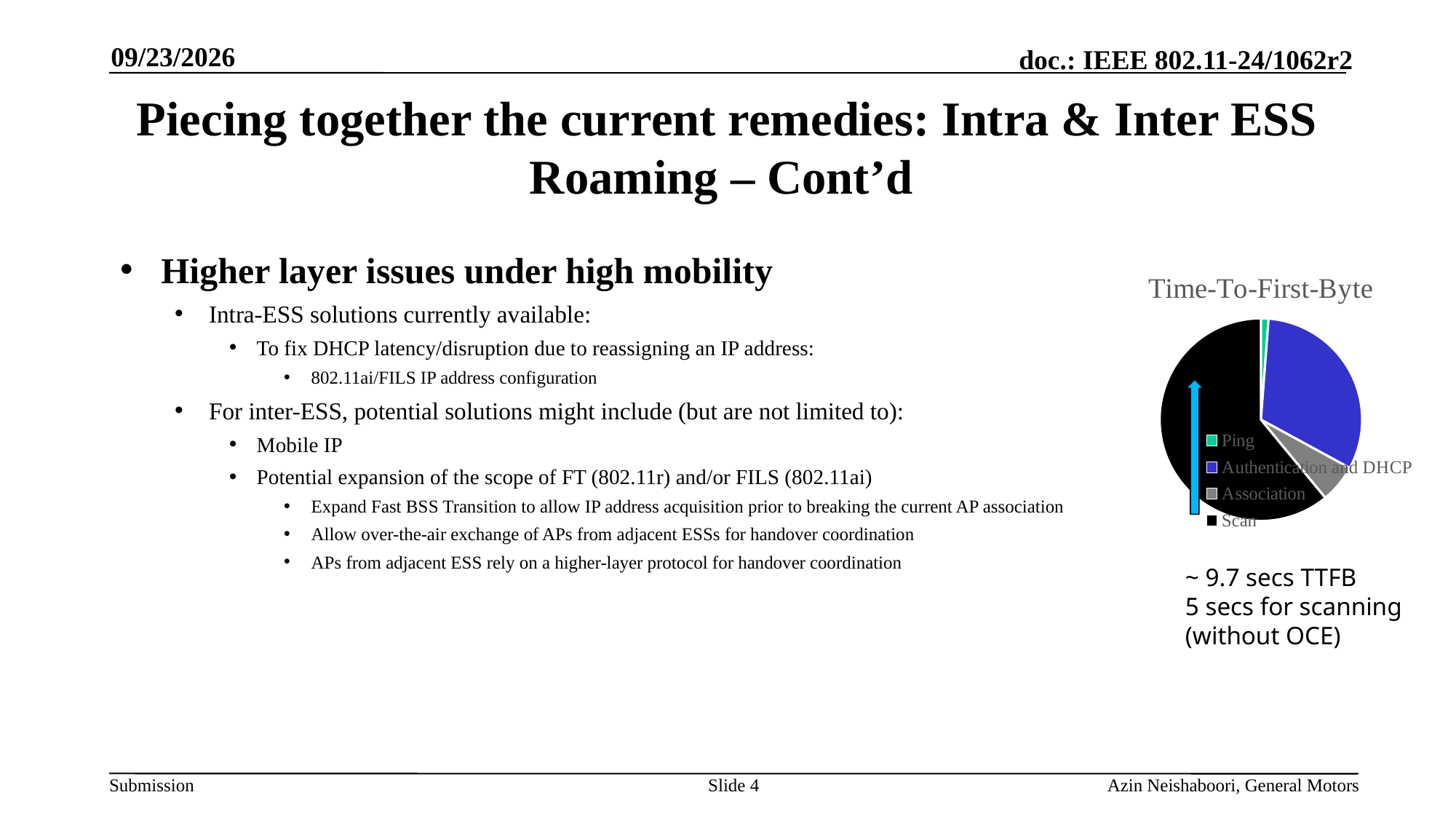
In the Time-To-First-Byte pie chart, which slice is larger: Authentication and DHCP or Association? Authentication and DHCP In the Time-To-First-Byte pie chart, which slice is larger: Association or Ping? Association Which category has the largest slice in the Time-To-First-Byte pie chart? Scan How many categories does the legend of the Time-To-First-Byte pie chart list? 4 In the Time-To-First-Byte pie chart, which slice is larger: Scan or Authentication and DHCP? Scan Which category has the smallest slice in the Time-To-First-Byte pie chart? Ping What kind of chart is shown on the slide? pie chart What colour is the Scan slice in the Time-To-First-Byte pie chart? black What is the title of the pie chart? Time-To-First-Byte